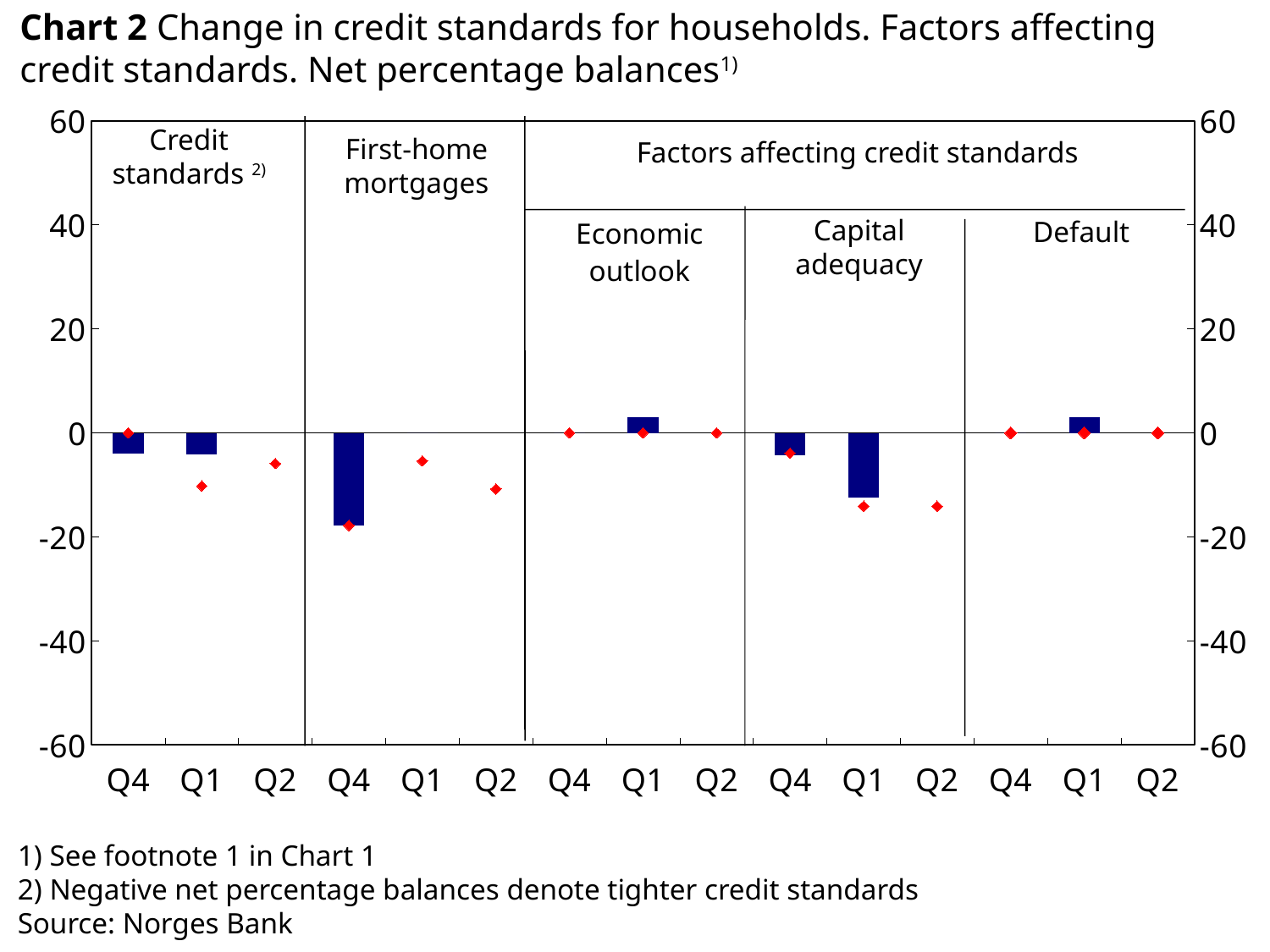
Is the Q1 bar in the Capital adequacy panel greater or less than 0? less How many quarter labels (Q4, Q1, Q2) appear along the x axis in total? 15 Is the Q4 bar in the First-home mortgages panel greater or less than -10? less Is the Q1 bar in the Default panel greater or less than 20? less Which panel contains the lowest bar in the chart? First-home mortgages What kind of chart is shown on the slide? combination bar and line chart (bars with red diamond markers) Which three factors affecting credit standards are named in the chart? Economic outlook, Capital adequacy, Default How many panels (sections) does the chart divide the x axis into? 5 Which is larger, the Q4 bar in the Credit standards panel or the Q4 bar in the First-home mortgages panel? Credit standards Q4 What is the maximum value shown on the y axis? 60